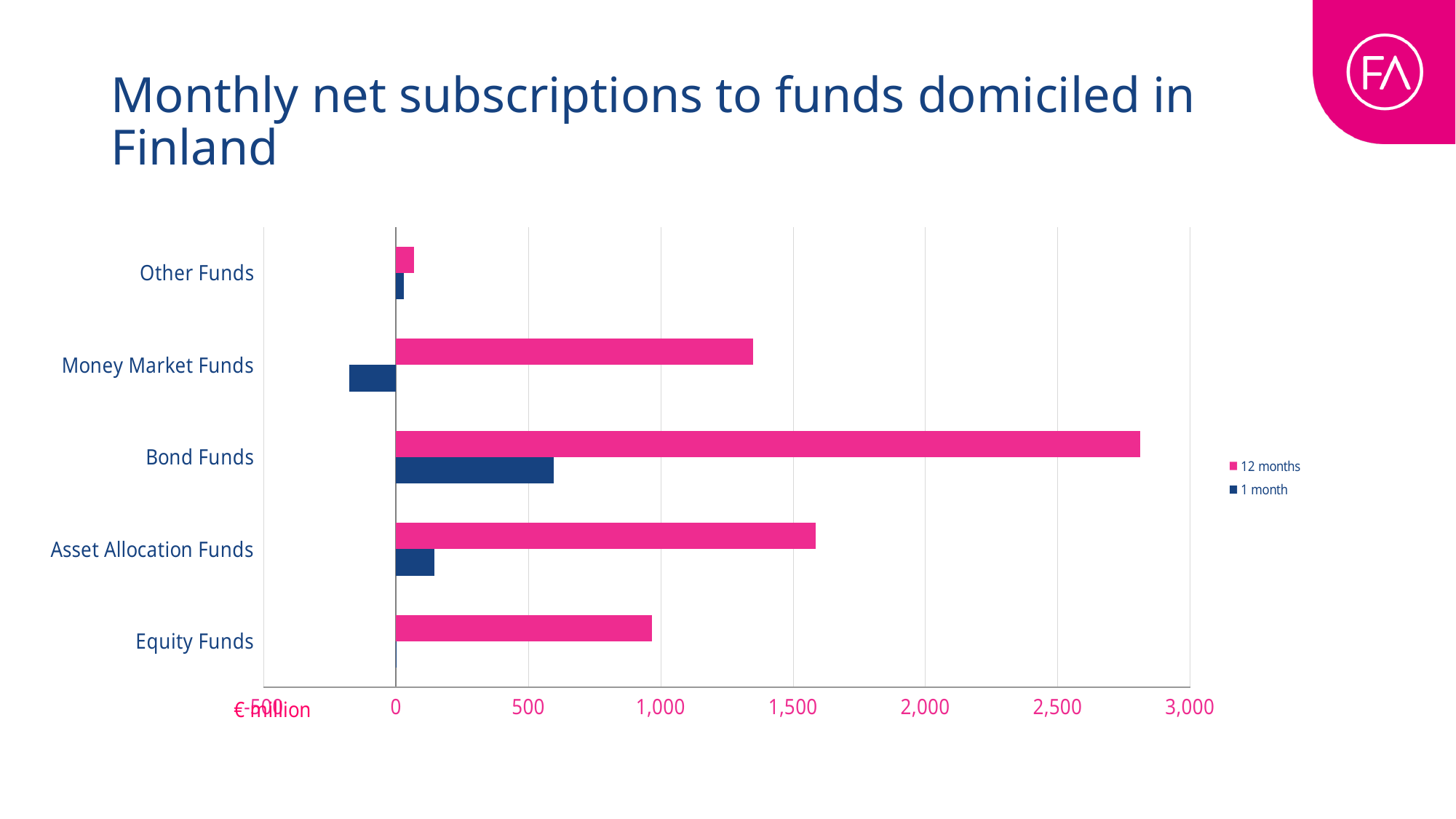
Which fund category has the lowest 12 months value? Other Funds Which is larger, the 12 months value for Asset Allocation Funds or the 12 months value for Money Market Funds? Asset Allocation Funds How many fund categories are shown on the chart? 5 How many series does the legend list? 2 Which fund category has the lowest 1 month value? Money Market Funds Which fund category has the highest 12 months value? Bond Funds What kind of chart is shown on the slide? bar chart Is the 12 months value for Equity Funds greater or less than 1,000? less What unit is shown on the x axis of the chart? € million Is the 12 months value for Bond Funds greater or less than 2,500? greater Which fund category has the highest 1 month value? Bond Funds Is the 1 month value for Money Market Funds greater or less than 0? less